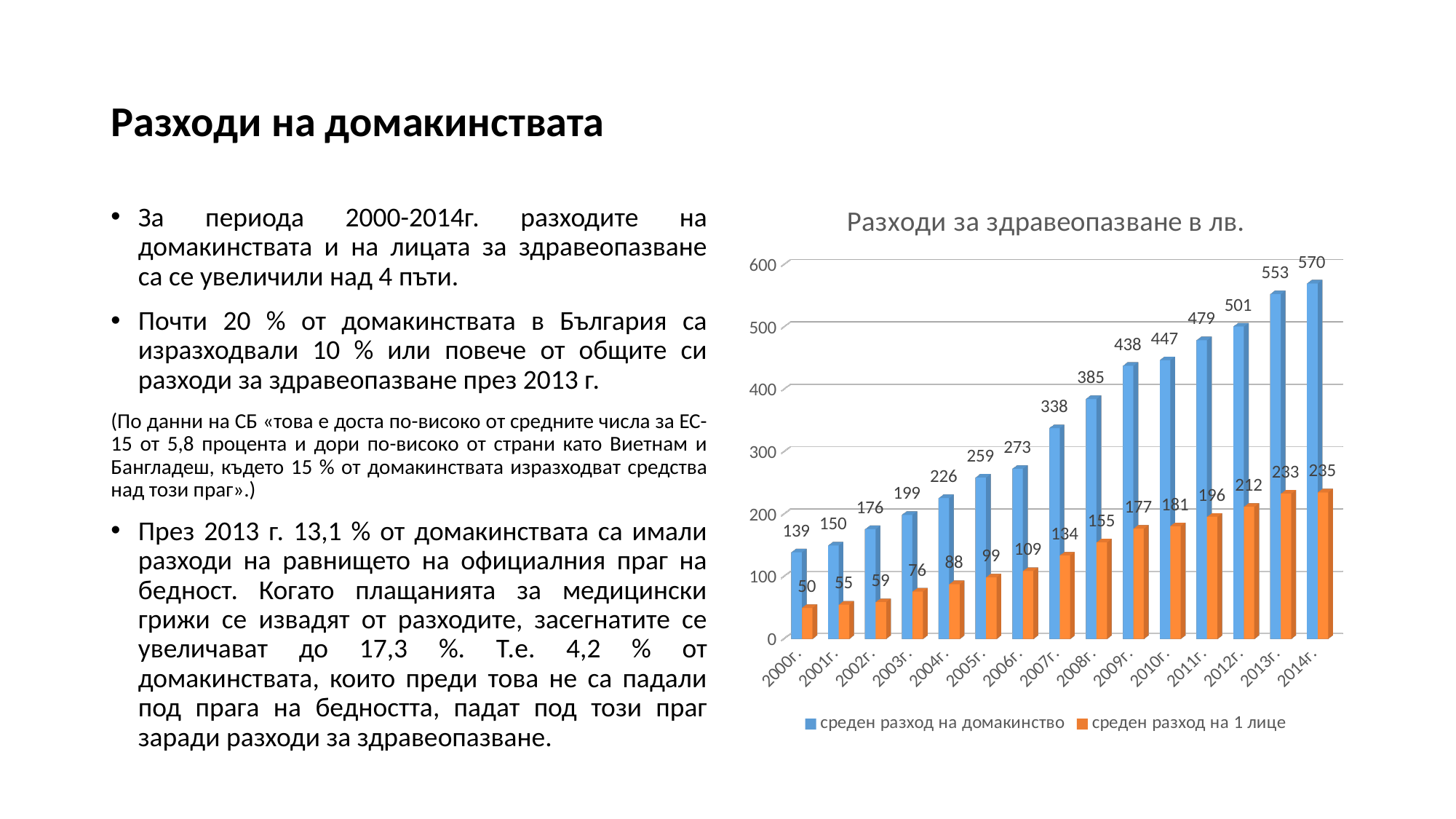
Which is larger: 'среден разход на домакинство' in 2005г. or 'среден разход на 1 лице' in 2014г.? среден разход на домакинство in 2005г. How many years are shown on the x axis? 15 Which year has the highest value for 'среден разход на домакинство'? 2014г. What is the difference between 'среден разход на домакинство' in 2014г. and in 2000г.? 431 What kind of chart is shown on the slide? bar chart How many series does the legend list? 2 What is the value for 'среден разход на домакинство' in 2007г.? 338 Do the values for 'среден разход на домакинство' rise or fall from 2000г. to 2014г.? rise Which year has the lowest value for 'среден разход на 1 лице'? 2000г. What is the value for 'среден разход на домакинство' in 2014г.? 570 What is the value for 'среден разход на 1 лице' in 2010г.? 181 What is the value for 'среден разход на 1 лице' in 2000г.? 50